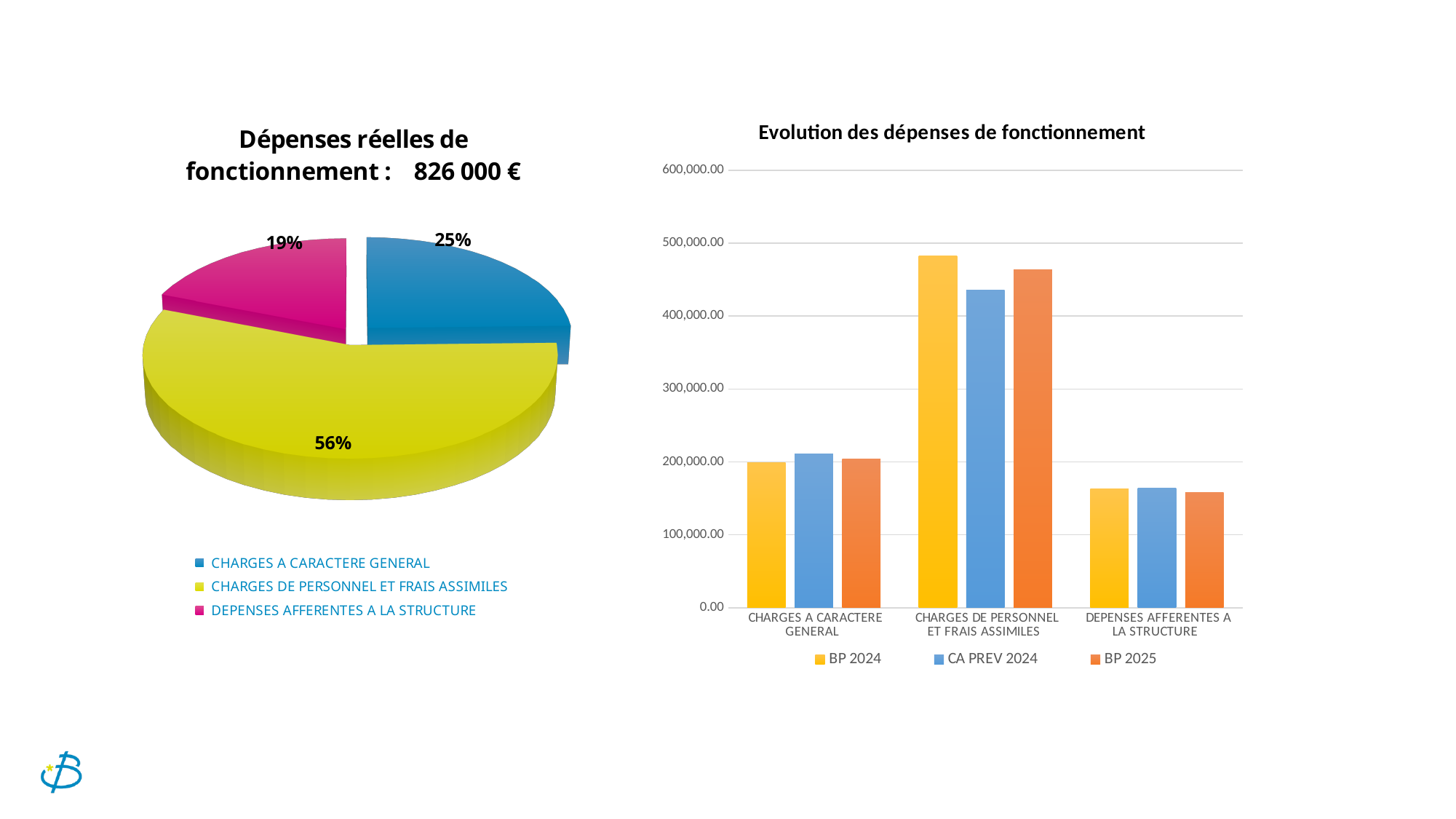
What total amount is shown in the title of the pie chart on the left? 826 000 € In the pie chart 'Dépenses réelles de fonctionnement', what share does DEPENSES AFFERENTES A LA STRUCTURE have? 19% In the pie chart 'Dépenses réelles de fonctionnement', how many slices are there? 3 In the pie chart 'Dépenses réelles de fonctionnement', what share does CHARGES DE PERSONNEL ET FRAIS ASSIMILES have? 56% In 'Evolution des dépenses de fonctionnement', is the BP 2024 value for CHARGES DE PERSONNEL ET FRAIS ASSIMILES greater or less than 400,000.00? greater In the pie chart 'Dépenses réelles de fonctionnement', which category has the smallest share? DEPENSES AFFERENTES A LA STRUCTURE In the pie chart 'Dépenses réelles de fonctionnement', which category has the largest share? CHARGES DE PERSONNEL ET FRAIS ASSIMILES In 'Evolution des dépenses de fonctionnement', which is larger for CHARGES DE PERSONNEL ET FRAIS ASSIMILES: BP 2024 or CA PREV 2024? BP 2024 In the pie chart 'Dépenses réelles de fonctionnement', what is the difference in percentage points between CHARGES A CARACTERE GENERAL and DEPENSES AFFERENTES A LA STRUCTURE? 6 percentage points What kind of chart is 'Evolution des dépenses de fonctionnement'? Bar chart In 'Evolution des dépenses de fonctionnement', is the BP 2025 value for DEPENSES AFFERENTES A LA STRUCTURE greater or less than 200,000.00? less How many series does the legend of 'Evolution des dépenses de fonctionnement' list? 3